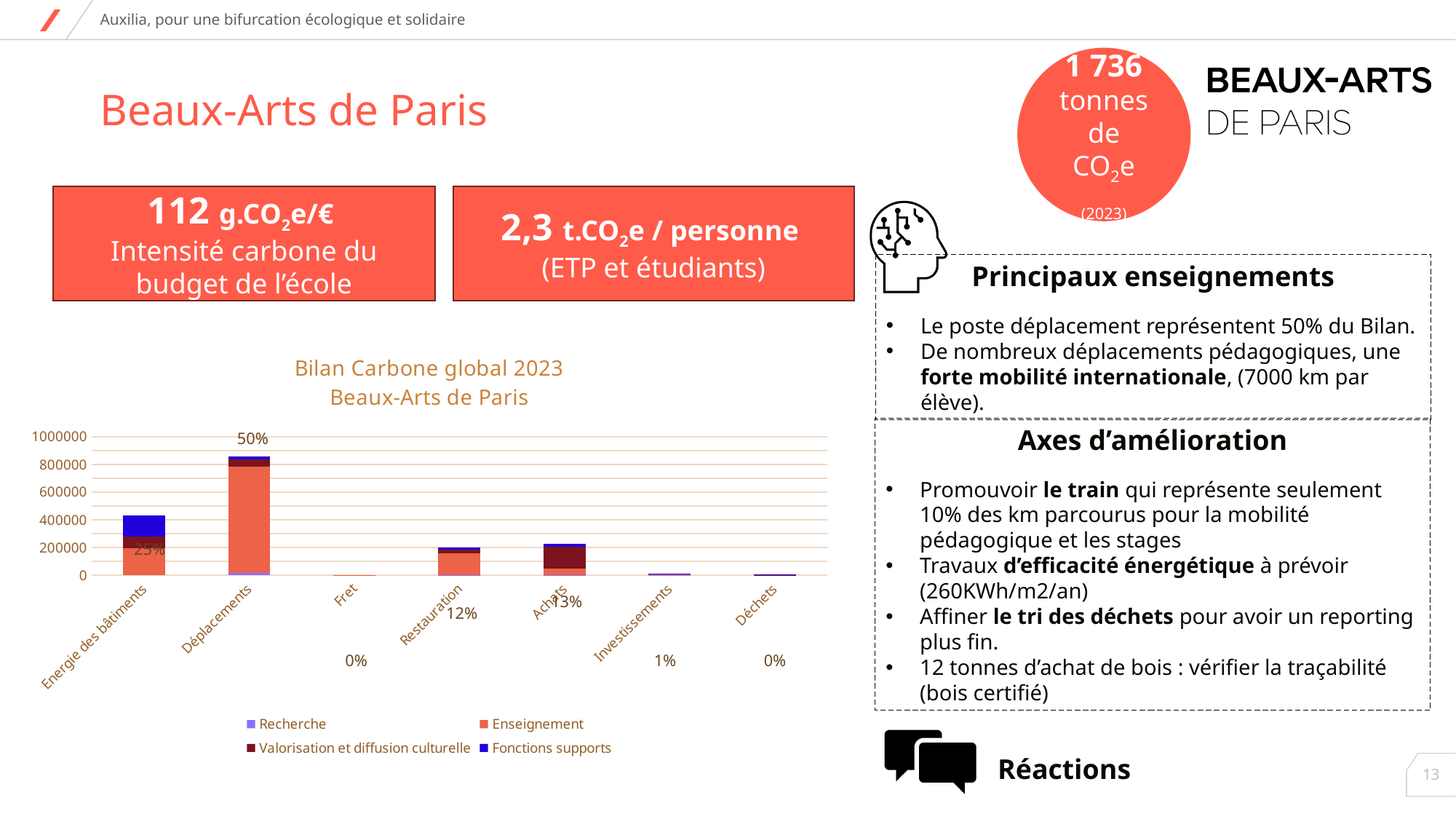
How many series does the chart legend list? 4 Which category has the highest total in the chart? Déplacements What kind of chart is shown on the slide? Stacked bar chart What percentage label is shown for Restauration? 12% What is the title of the chart? Bilan Carbone global 2023 Beaux-Arts de Paris What percentage label is shown for Energie des bâtiments? 25% Is the total value for Déplacements greater or less than 800000? greater What percentage label is shown for Déplacements? 50% How many categories are shown on the x axis of the chart? 7 What percentage label is shown for Achats? 13% Is the total value for Energie des bâtiments greater or less than 600000? less Which is larger, the total for Déplacements or the total for Energie des bâtiments? Déplacements